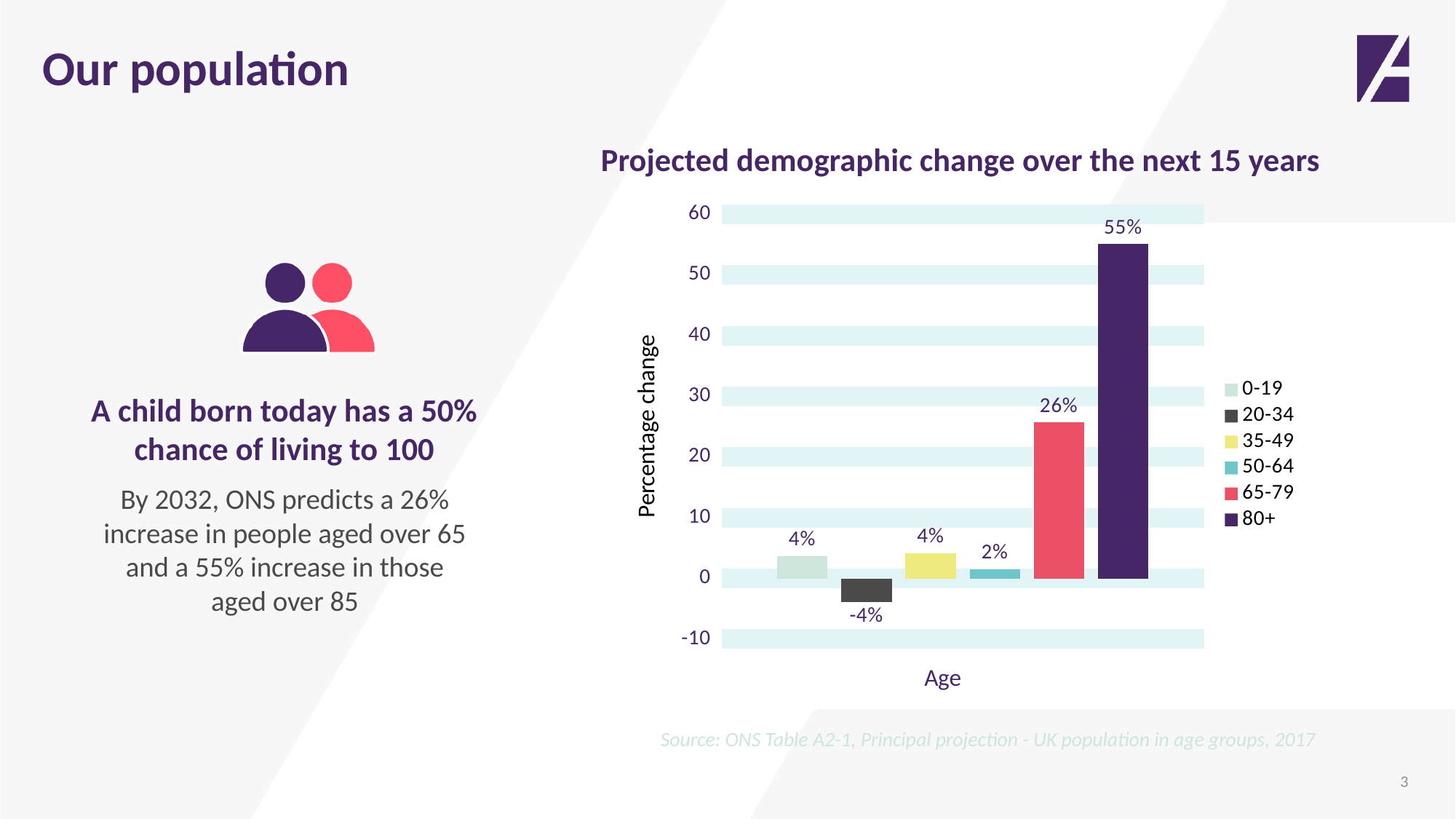
Which age group has the highest projected percentage change? 80+ Which age group has the lowest projected percentage change? 20-34 What is the projected percentage change for the 20-34 age group? -4% What is the projected percentage change for the 65-79 age group? 26% Which has a larger projected percentage change, the 65-79 group or the 50-64 group? 65-79 How many age groups are listed in the chart legend? 6 What is the title of the chart? Projected demographic change over the next 15 years Is the value for the 80+ age group greater or less than 50? greater What is the projected percentage change for the 80+ age group? 55% What type of chart is used to show the projected demographic change? Bar chart What is the projected percentage change for the 50-64 age group? 2% What is the difference between the projected percentage change for the 80+ group and the 65-79 group? 29%